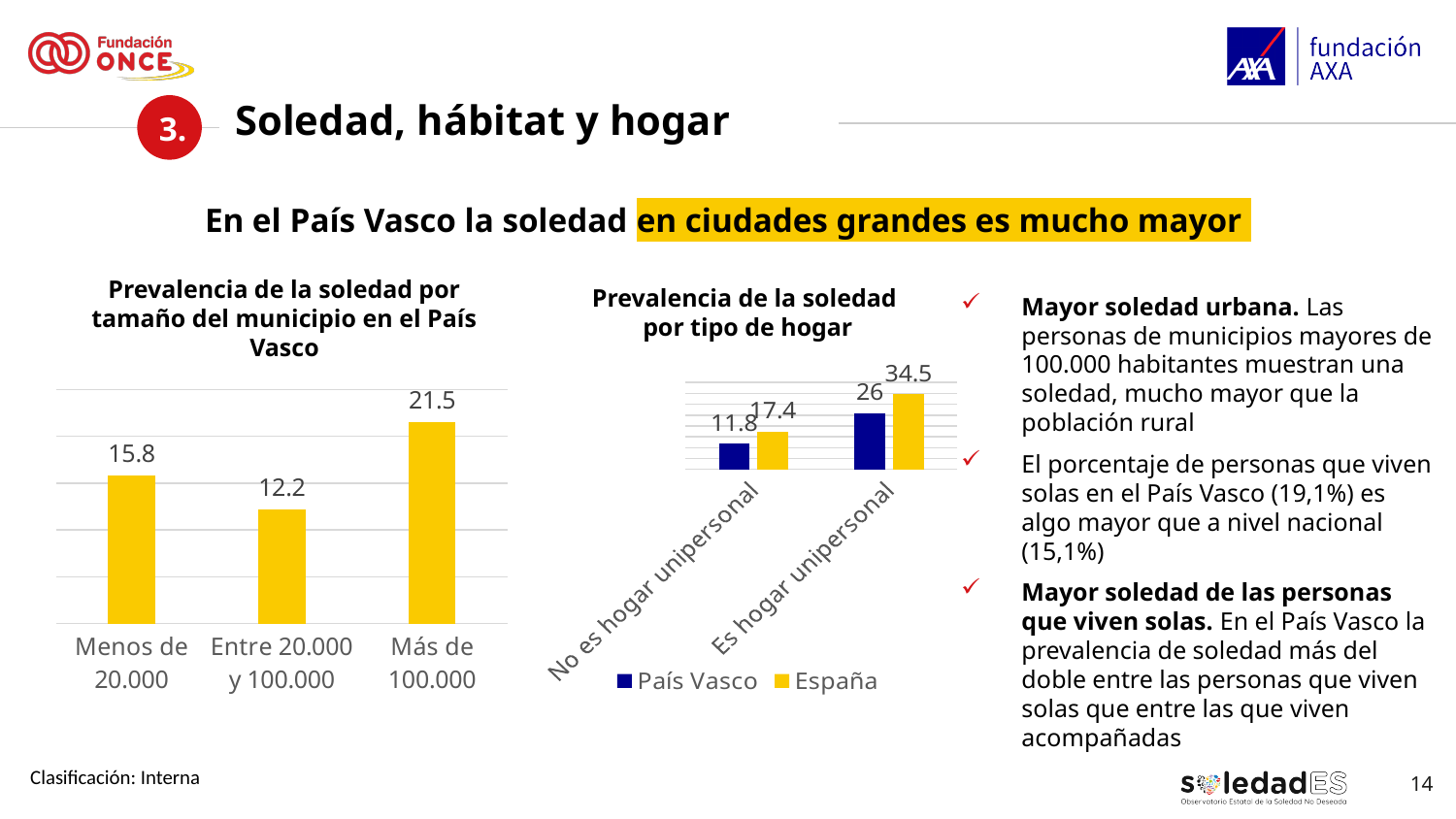
In the chart 'Prevalencia de la soledad por tamaño del municipio en el País Vasco', what is the difference between the values for 'Más de 100.000' and 'Menos de 20.000'? 5.7 In the chart 'Prevalencia de la soledad por tipo de hogar', how many series does the legend list? 2 In the chart 'Prevalencia de la soledad por tamaño del municipio en el País Vasco', what is the value for 'Más de 100.000'? 21.5 In the chart 'Prevalencia de la soledad por tipo de hogar', which is larger for 'Es hogar unipersonal': País Vasco or España? España In the chart 'Prevalencia de la soledad por tipo de hogar', what is the value for España in 'Es hogar unipersonal'? 34.5 In the chart 'Prevalencia de la soledad por tamaño del municipio en el País Vasco', which category has the lowest value? Entre 20.000 y 100.000 In the chart 'Prevalencia de la soledad por tamaño del municipio en el País Vasco', what is the value for 'Entre 20.000 y 100.000'? 12.2 In the chart 'Prevalencia de la soledad por tamaño del municipio en el País Vasco', which category has the highest value? Más de 100.000 In the chart 'Prevalencia de la soledad por tamaño del municipio en el País Vasco', how many categories are shown? 3 What kind of chart is 'Prevalencia de la soledad por tamaño del municipio en el País Vasco'? Bar chart In the chart 'Prevalencia de la soledad por tipo de hogar', what is the difference between España and País Vasco for 'Es hogar unipersonal'? 8.5 In the chart 'Prevalencia de la soledad por tipo de hogar', what is the value for País Vasco in 'No es hogar unipersonal'? 11.8